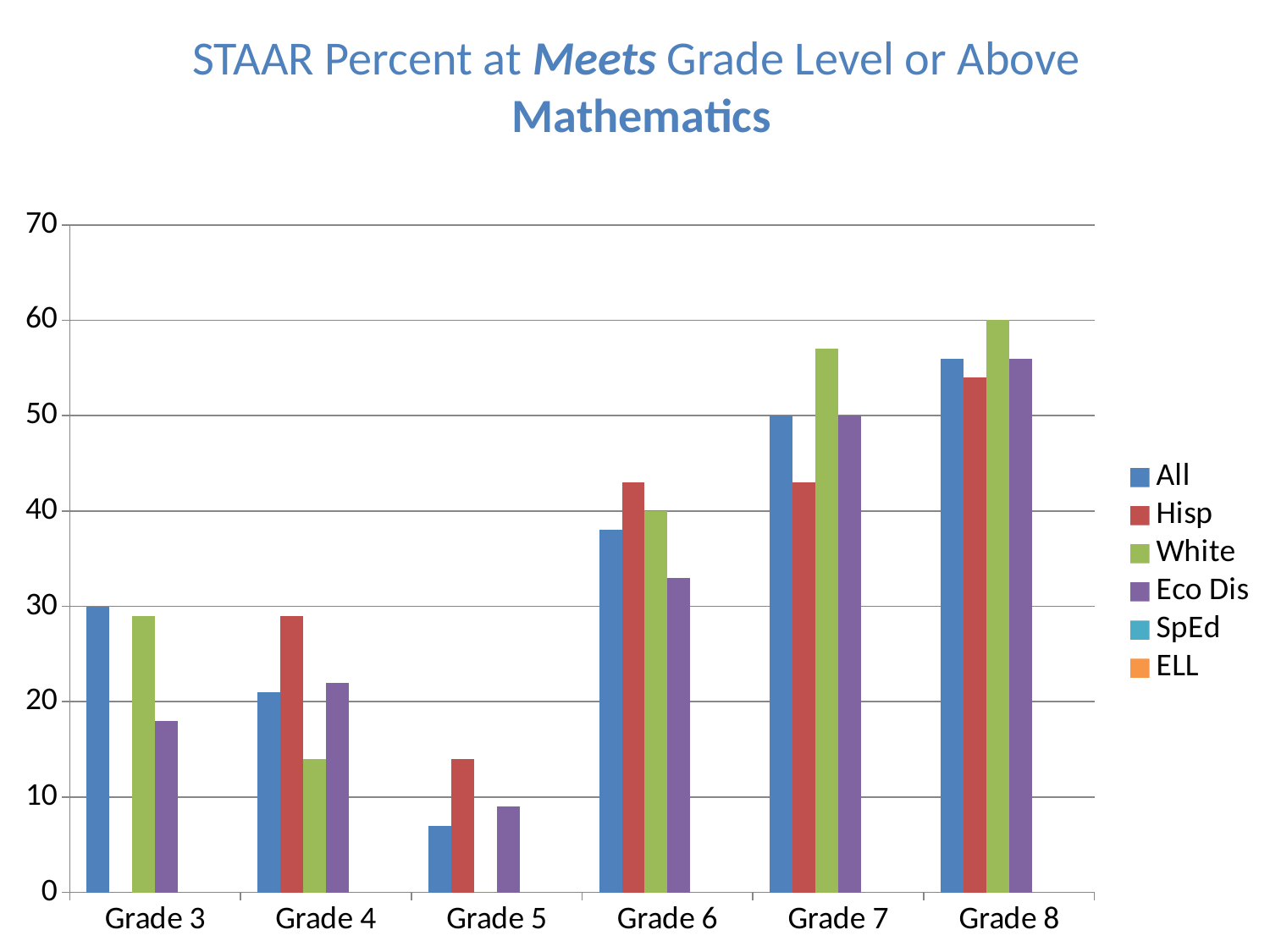
Which grade has the highest value for the White series? Grade 8 How many series does the legend list? 6 Which grade has the lowest value for the All series? Grade 5 In Grade 4, which is larger, the value for Hisp or the value for White? Hisp Is the value for Hisp in Grade 6 greater or less than 40? greater Is the value for All in Grade 5 greater or less than 10? less What is the value for All in Grade 7? 50 What is the value for White in Grade 8? 60 How many grade categories are shown on the x axis? 6 Is the value for White in Grade 7 greater or less than 50? greater What is the value for All in Grade 3? 30 What kind of chart is shown on the slide? bar chart